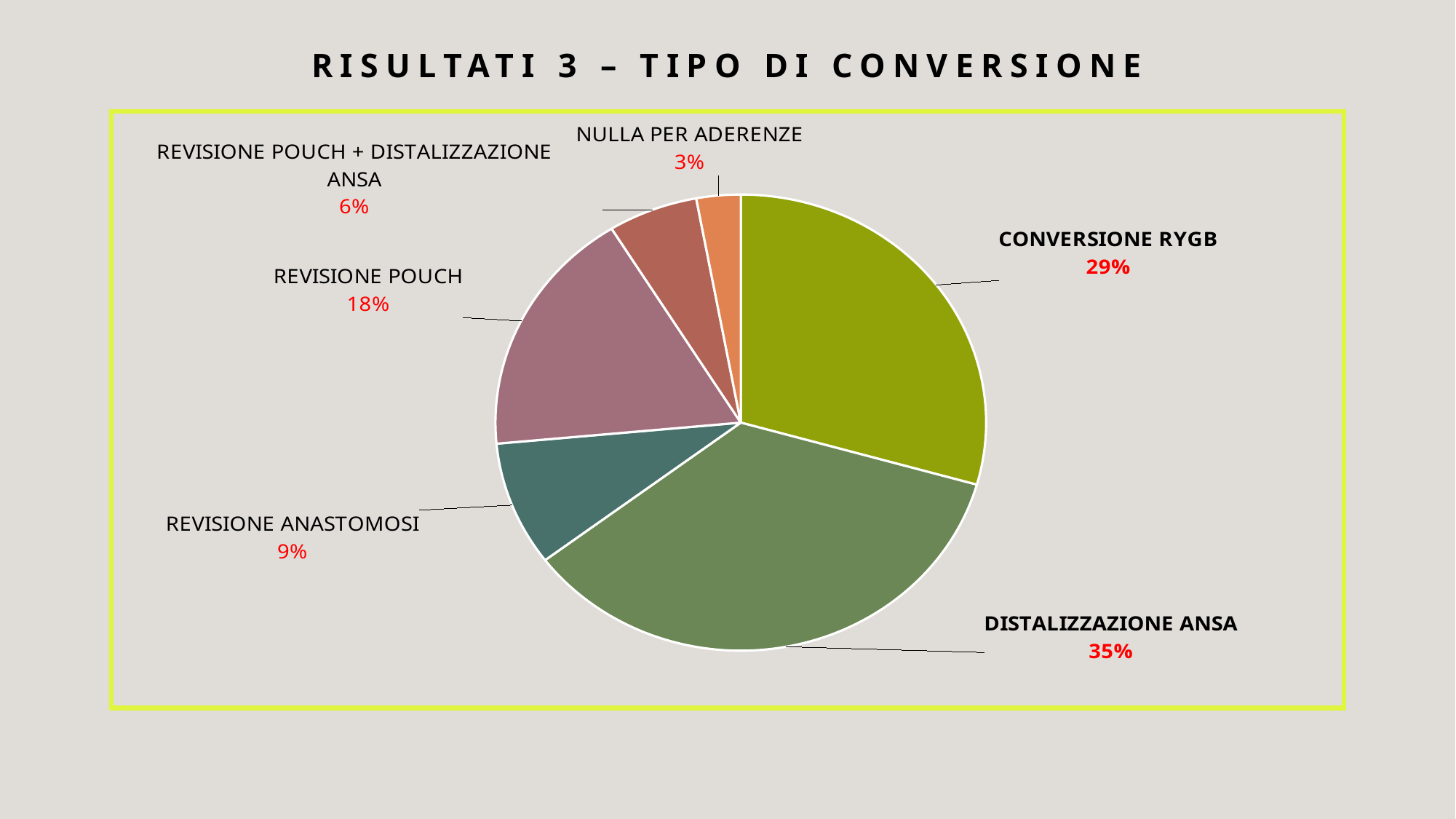
What is the value for REVISIONE POUCH? 18% What is the difference between DISTALIZZAZIONE ANSA and CONVERSIONE RYGB? 6% Which category has the largest slice of the pie? DISTALIZZAZIONE ANSA How many categories are shown in the pie chart? 6 What share of the pie does DISTALIZZAZIONE ANSA have? 35% What is the value for REVISIONE ANASTOMOSI? 9% Which is larger, REVISIONE POUCH or REVISIONE ANASTOMOSI? REVISIONE POUCH What kind of chart is shown on the slide? pie chart What share of the pie does CONVERSIONE RYGB have? 29% Which category has the smallest slice of the pie? NULLA PER ADERENZE What is the value for NULLA PER ADERENZE? 3% What is the title of the slide? RISULTATI 3 – TIPO DI CONVERSIONE